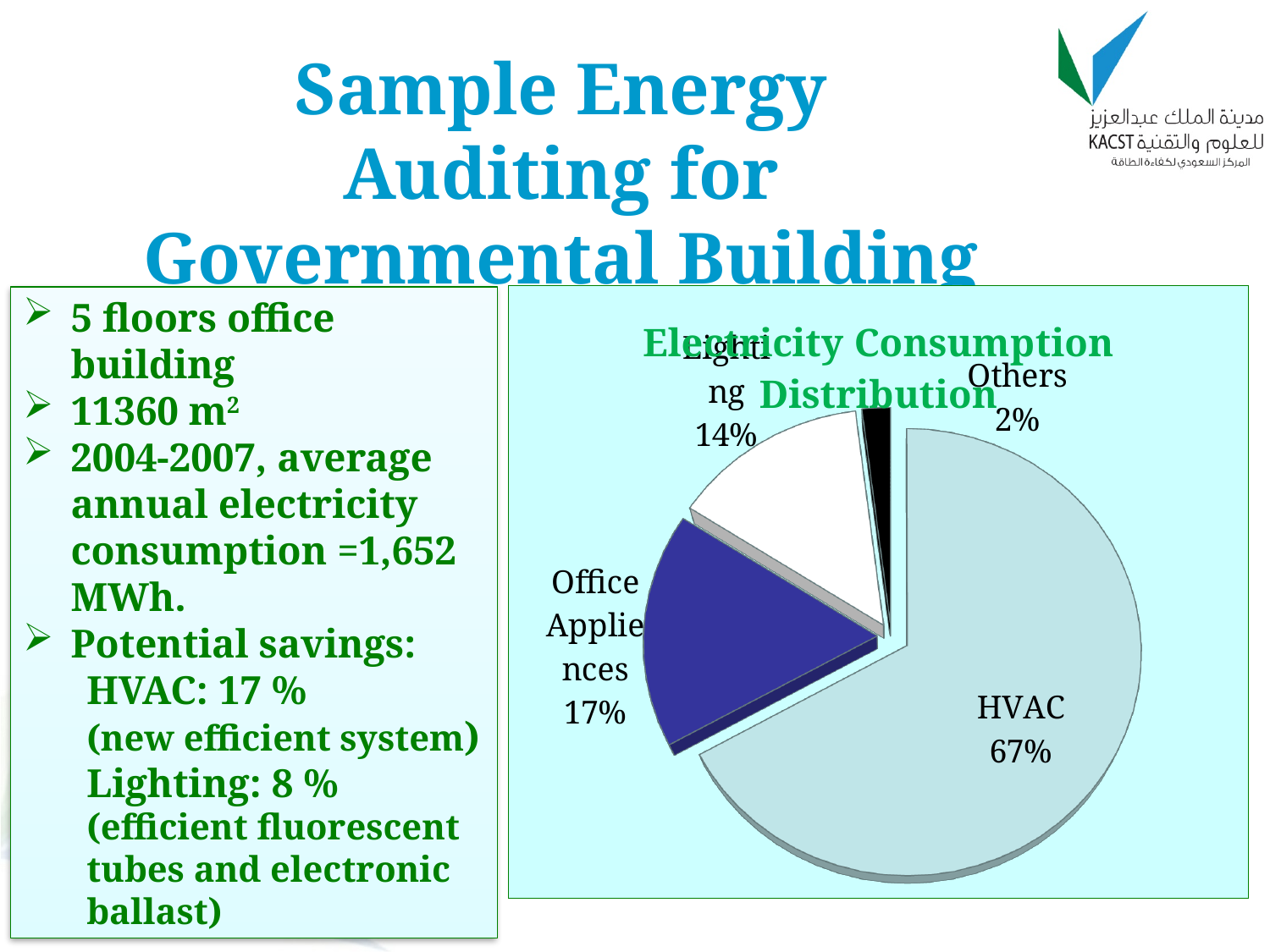
What is the title of the chart? Electricity Consumption Distribution How many slices does the pie chart have? 4 What is the difference in percentage points between Lighting and Others? 12 Which is larger, the share for Office Appliances or the share for Lighting? Office Appliances What is the difference in percentage points between HVAC and Office Appliances? 50 What share of electricity consumption does HVAC account for? 67% Which category has the smallest share of electricity consumption? Others What type of chart is shown on the slide? Pie chart What percentage is shown for the Others slice? 2% What is the value shown for Lighting in the pie chart? 14% Which category has the largest share of electricity consumption? HVAC What percentage of electricity consumption is attributed to Office Appliances? 17%